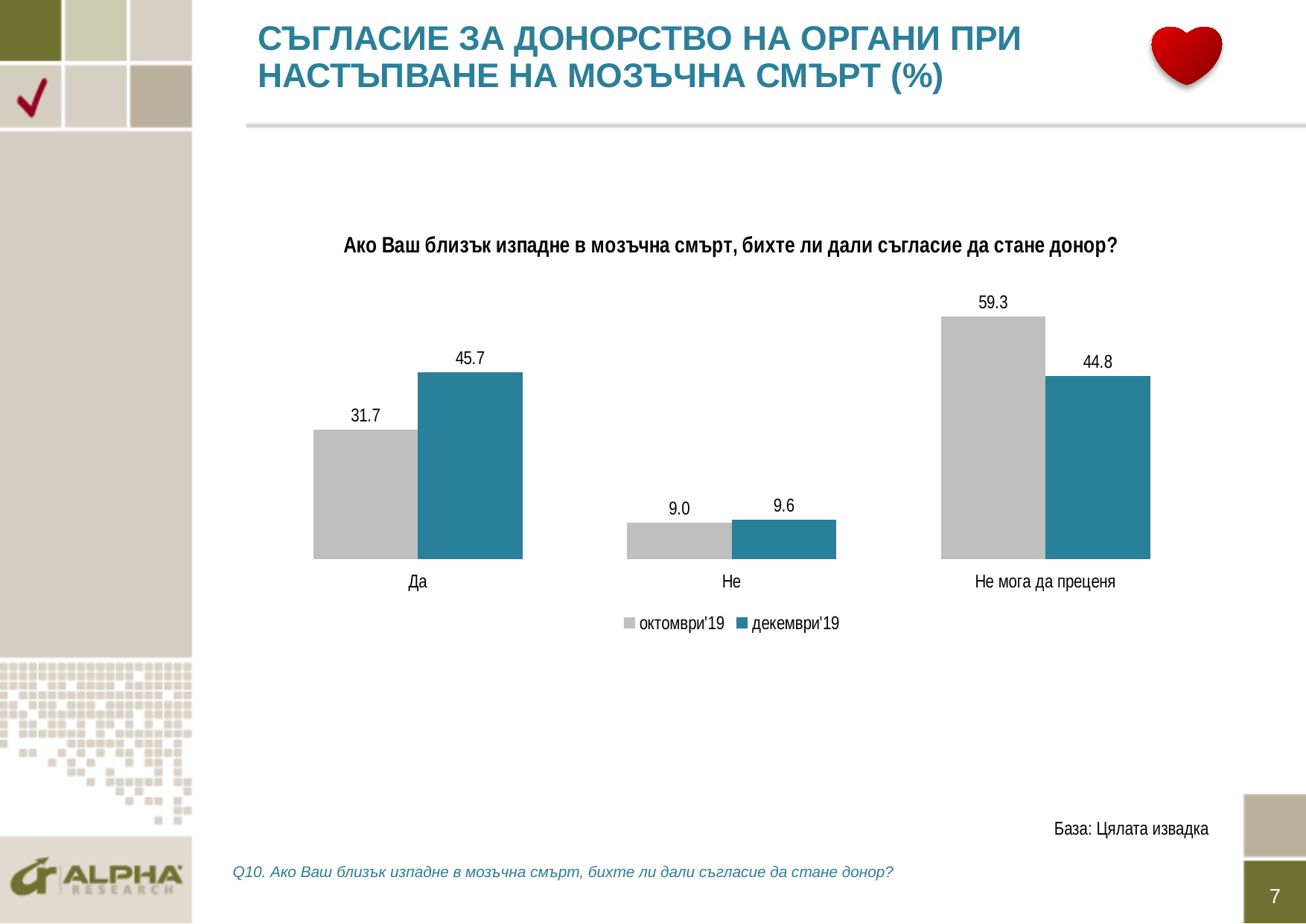
What kind of chart is shown on the slide? Bar chart What is the value for "Да" in the октомври'19 series? 31.7 Which category has the lowest value in the декември'19 series? Не How many categories are shown on the x axis? 3 What is the value for "Да" in the декември'19 series? 45.7 How many series does the legend list? 2 Which is larger for "Не мога да преценя": the октомври'19 value or the декември'19 value? октомври'19 What is the difference between the октомври'19 and декември'19 values for "Не мога да преценя"? 14.5 What is the difference between the декември'19 and октомври'19 values for "Да"? 14.0 What is the value for "Не" in the октомври'19 series? 9.0 What is the value for "Не мога да преценя" in the декември'19 series? 44.8 Which category has the highest value in the октомври'19 series? Не мога да преценя